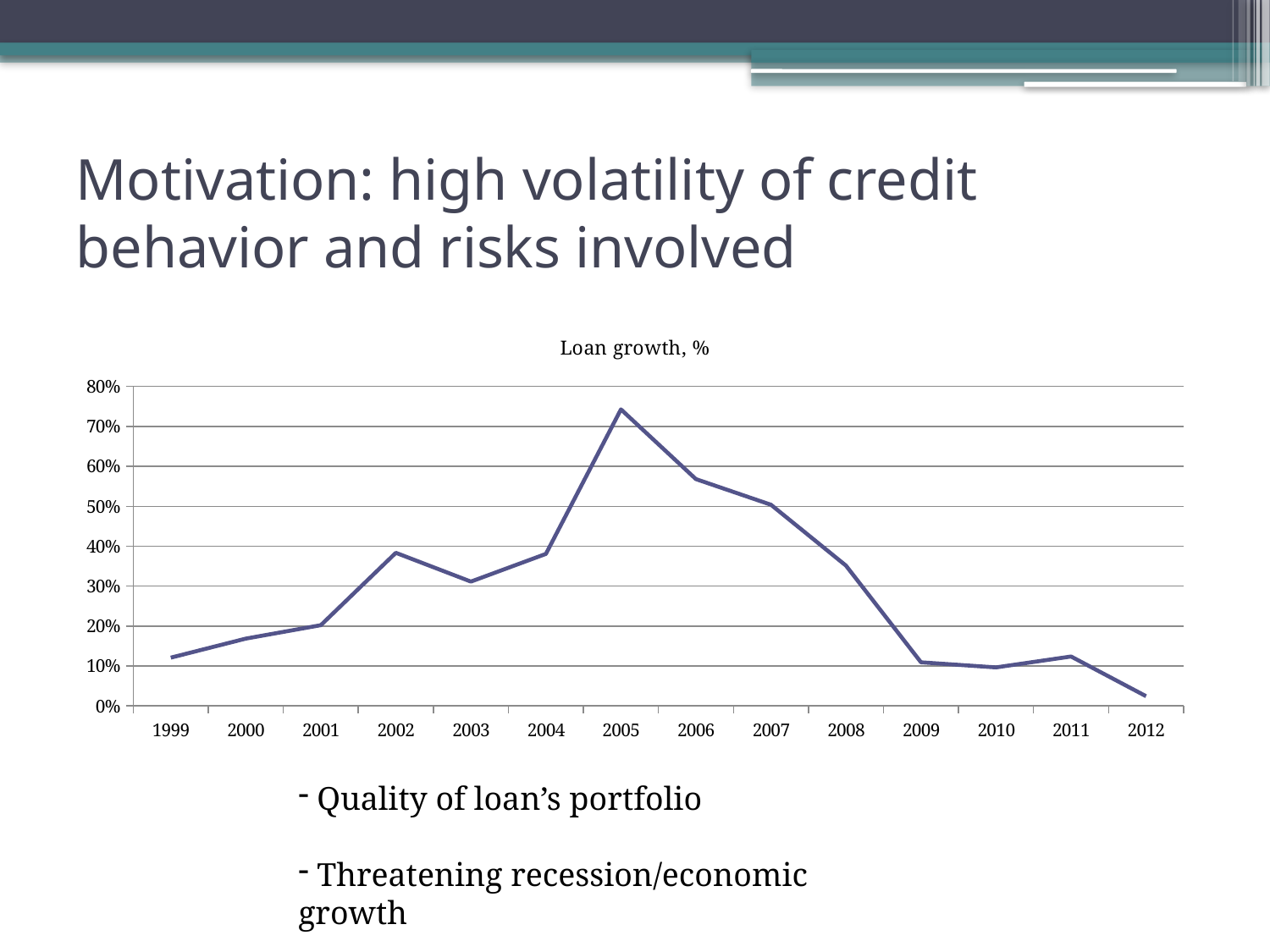
Does loan growth rise or fall from 2005 to 2012? fall How many years are plotted on the x axis of the chart? 14 Is the loan growth value for 2012 greater or less than 10%? less What is the title of the chart? Loan growth, % Which year has higher loan growth, 2002 or 2003? 2002 Is the loan growth value for 2005 greater or less than 70%? greater Which year has higher loan growth, 2006 or 2008? 2006 What kind of chart is shown on the slide? line chart Is the loan growth value for 2008 greater or less than 40%? less In which year is loan growth lowest? 2012 In which year is loan growth highest? 2005